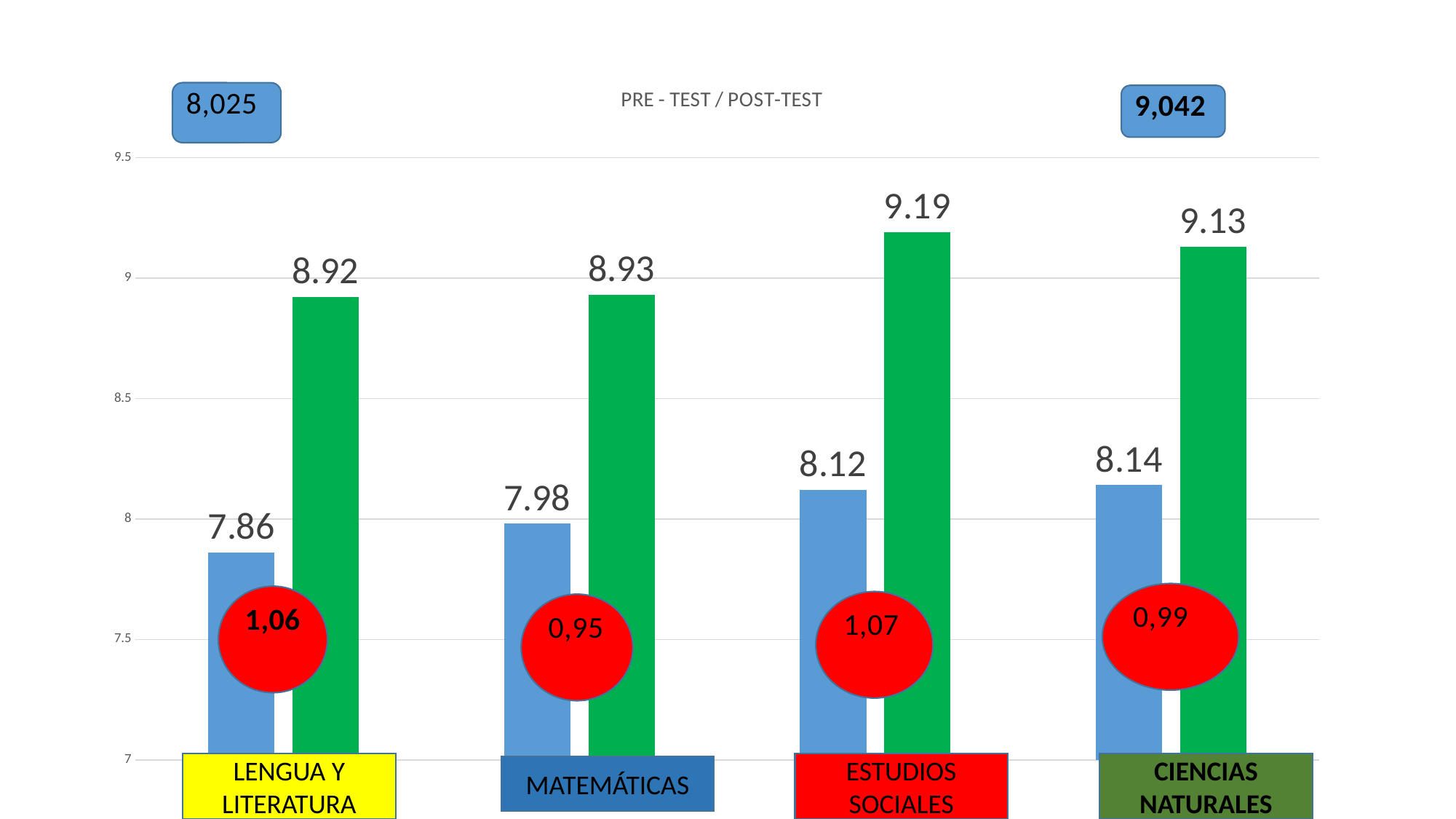
Which category has the lowest blue bar? LENGUA Y LITERATURA What is the value of the green bar for CIENCIAS NATURALES? 9.13 What is the value of the green bar for ESTUDIOS SOCIALES? 9.19 Which has the larger green bar, ESTUDIOS SOCIALES or CIENCIAS NATURALES? ESTUDIOS SOCIALES What kind of chart is shown on the slide? bar chart What is the title of the chart? PRE - TEST / POST-TEST Which category has the highest green bar? ESTUDIOS SOCIALES What is the value of the blue bar for MATEMÁTICAS? 7.98 What is the difference between the green bar and the blue bar for LENGUA Y LITERATURA? 1.06 Is the value of the blue bar for CIENCIAS NATURALES greater or less than 8? greater Which has the larger blue bar, MATEMÁTICAS or LENGUA Y LITERATURA? MATEMÁTICAS How many categories are shown on the x axis? 4